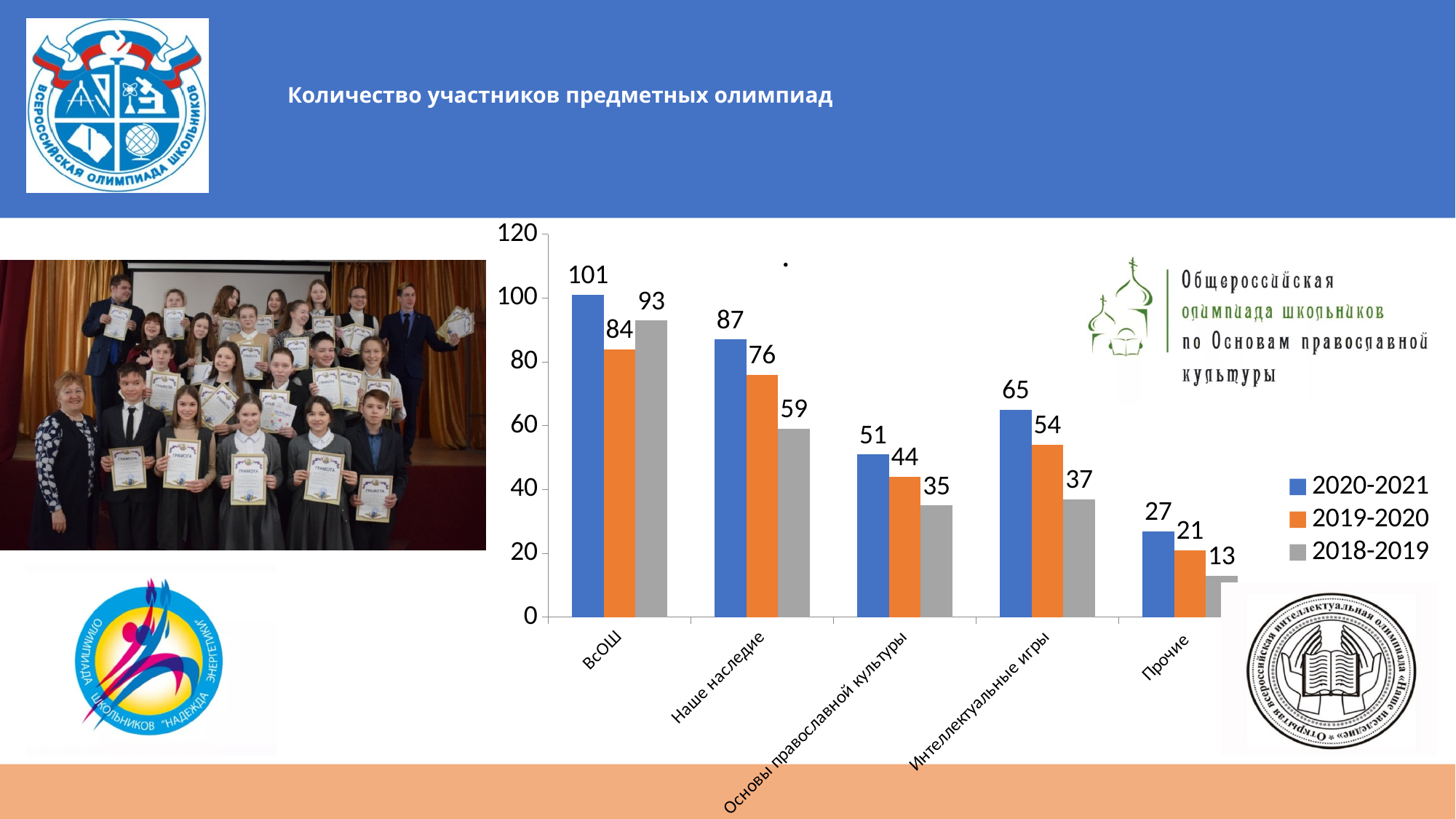
Which is larger for ВсОШ: the 2019-2020 value or the 2018-2019 value? 2018-2019 Which colour represents the 2019-2020 series in the legend? Orange Which category has the highest value in the 2020-2021 series? ВсОШ Which category has the lowest value in the 2018-2019 series? Прочие What is the difference between the 2020-2021 and 2019-2020 values for Интеллектуальные игры? 11 What is the value for Наше наследие in the 2018-2019 series? 59 How many series does the legend list? 3 How many categories are shown on the x axis? 5 What is the value for Прочие in the 2019-2020 series? 21 What is the total of the three series values for Основы православной культуры? 130 What is the value for ВсОШ in the 2020-2021 series? 101 What kind of chart is shown on the slide? Bar chart